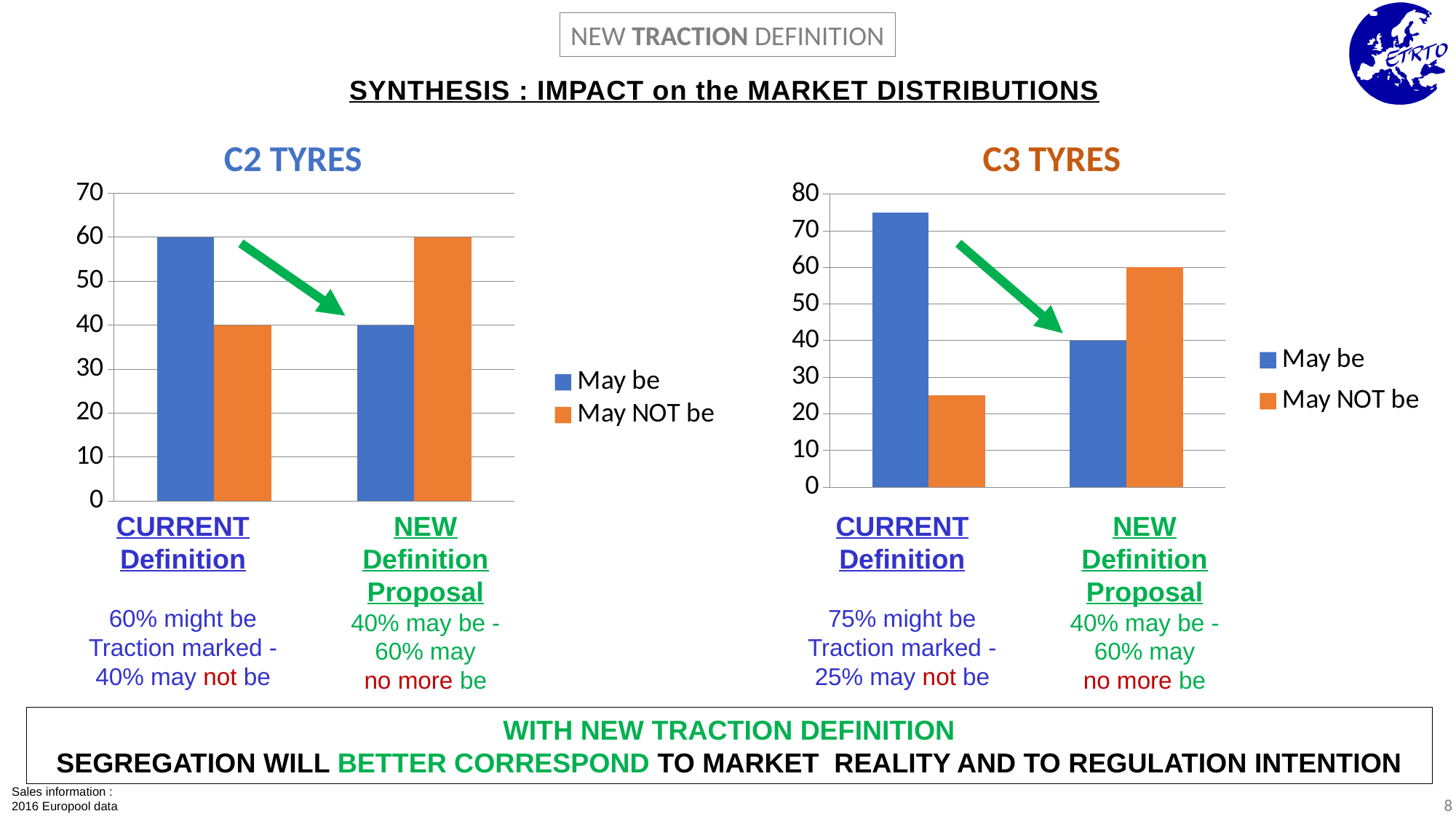
How many categories are shown on the x axis of the C3 TYRES chart? 2 On the C3 TYRES chart, does the May be value rise or fall from CURRENT Definition to NEW Definition Proposal? fall How many series does the legend of the C2 TYRES chart list? 2 On the C2 TYRES chart, which is larger for NEW Definition Proposal: May be or May NOT be? May NOT be What type of chart is the C2 TYRES chart? bar chart On the C2 TYRES chart, what is the value of the May be series for CURRENT Definition? 60 On the C3 TYRES chart, is the May be value for CURRENT Definition greater or less than 70? greater On the C3 TYRES chart, is the May NOT be value for CURRENT Definition greater or less than 30? less On the C2 TYRES chart, what is the difference between the May be and May NOT be values for CURRENT Definition? 20 On the C3 TYRES chart, which category has the highest May be value? CURRENT Definition On the C3 TYRES chart, what is the value of the May be series for NEW Definition Proposal? 40 On the C2 TYRES chart, what is the value of the May NOT be series for NEW Definition Proposal? 60